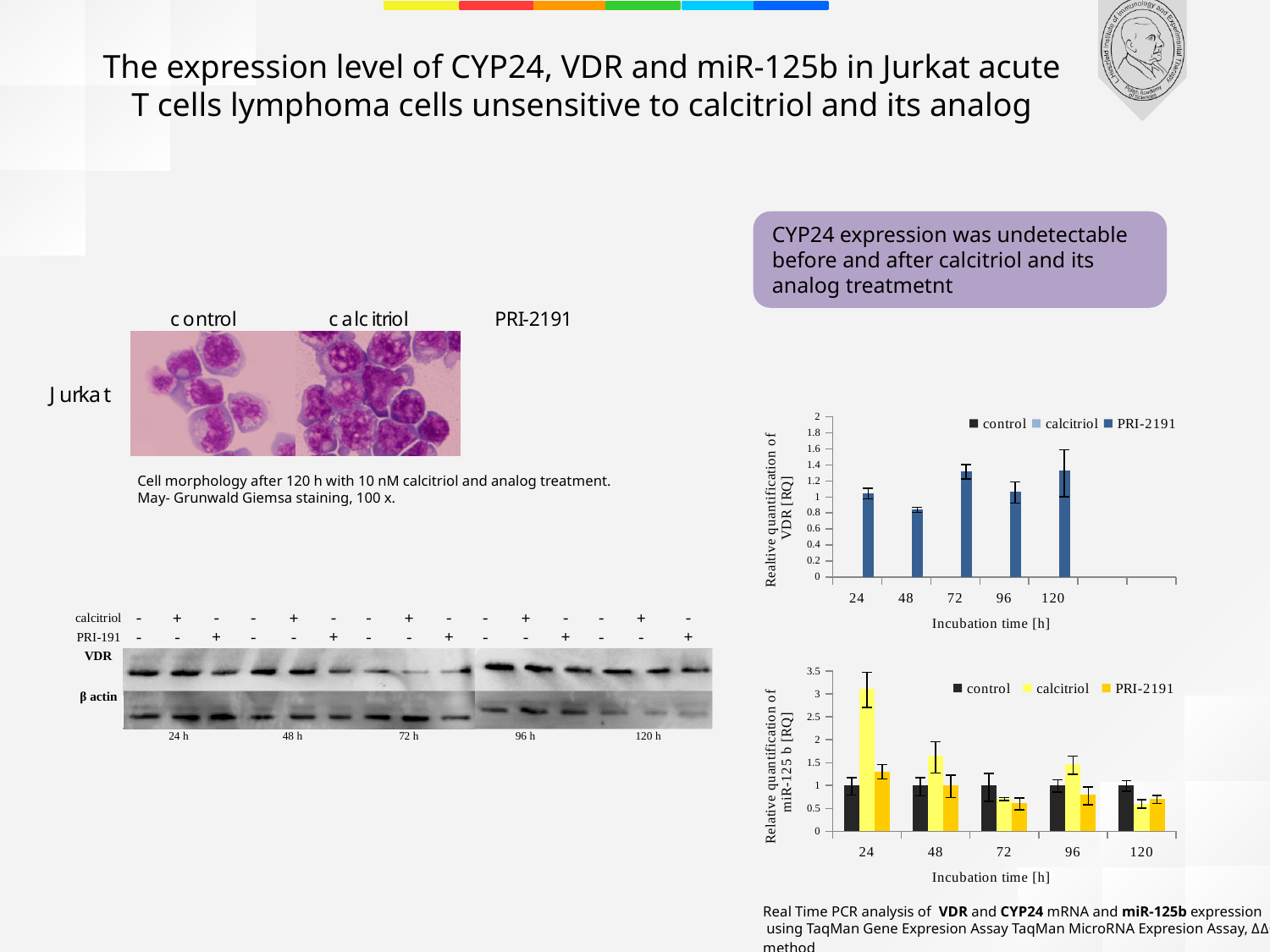
How many series does the legend of the bottom chart (Relative quantification of miR-125b) list? 3 What are the legend entries of the bottom chart (Relative quantification of miR-125b)? control, calcitriol, PRI-2191 How many incubation time points are shown on the x axis of the bottom chart (Relative quantification of miR-125b)? 5 In the top chart (Relative quantification of VDR), at which incubation time is the plotted bar lowest? 48 In the bottom chart (Relative quantification of miR-125b), is the calcitriol value at 24 h greater or less than 2.5? greater In the bottom chart (Relative quantification of miR-125b), which is larger: the calcitriol value at 24 h or the calcitriol value at 120 h? calcitriol at 24 h In the top chart (Relative quantification of VDR), is the value at 72 h greater or less than 1? greater What kind of chart is the top chart on the right (Relative quantification of VDR)? bar chart In the top chart (Relative quantification of VDR), is the value at 48 h greater or less than 1? less In the bottom chart (Relative quantification of miR-125b), which series has the highest bar at 24 h? calcitriol What is the x-axis title of the top chart (Relative quantification of VDR)? Incubation time [h]